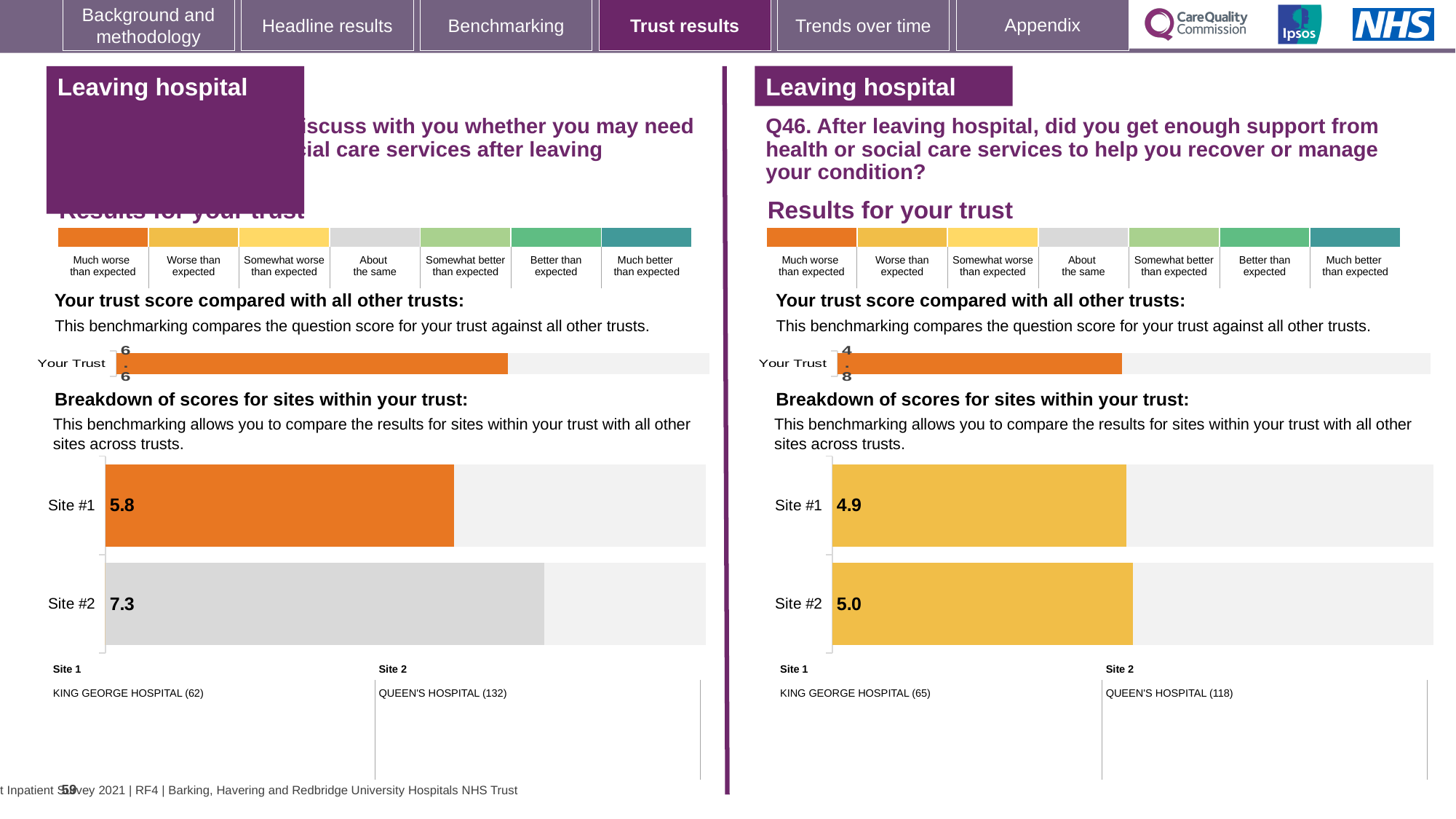
In the left-hand 'Your trust score compared with all other trusts' chart, what is the value shown for Your Trust? 6.6 In the right-hand (Q46) 'Your trust score compared with all other trusts' chart, what is the value shown for Your Trust? 4.8 In the right-hand (Q46) 'Breakdown of scores for sites within your trust' chart, what is the score for Site #2? 5.0 In the left-hand site breakdown chart, what is the difference between the Site #2 and Site #1 scores? 1.5 In the left-hand 'Breakdown of scores for sites within your trust' chart, what is the score for Site #1? 5.8 In the left-hand 'Breakdown of scores for sites within your trust' chart, what is the score for Site #2? 7.3 What type of chart is used for the site breakdown on the left-hand side of the slide? Bar chart In the right-hand (Q46) site breakdown chart, what is the difference between the Site #2 and Site #1 scores? 0.1 In the right-hand (Q46) 'Breakdown of scores for sites within your trust' chart, what is the score for Site #1? 4.9 In the left-hand site breakdown chart, what colour is the bar for Site #1? Orange In the left-hand site breakdown chart, which site has the higher score? Site #2 How many sites are shown in the right-hand (Q46) site breakdown chart? 2